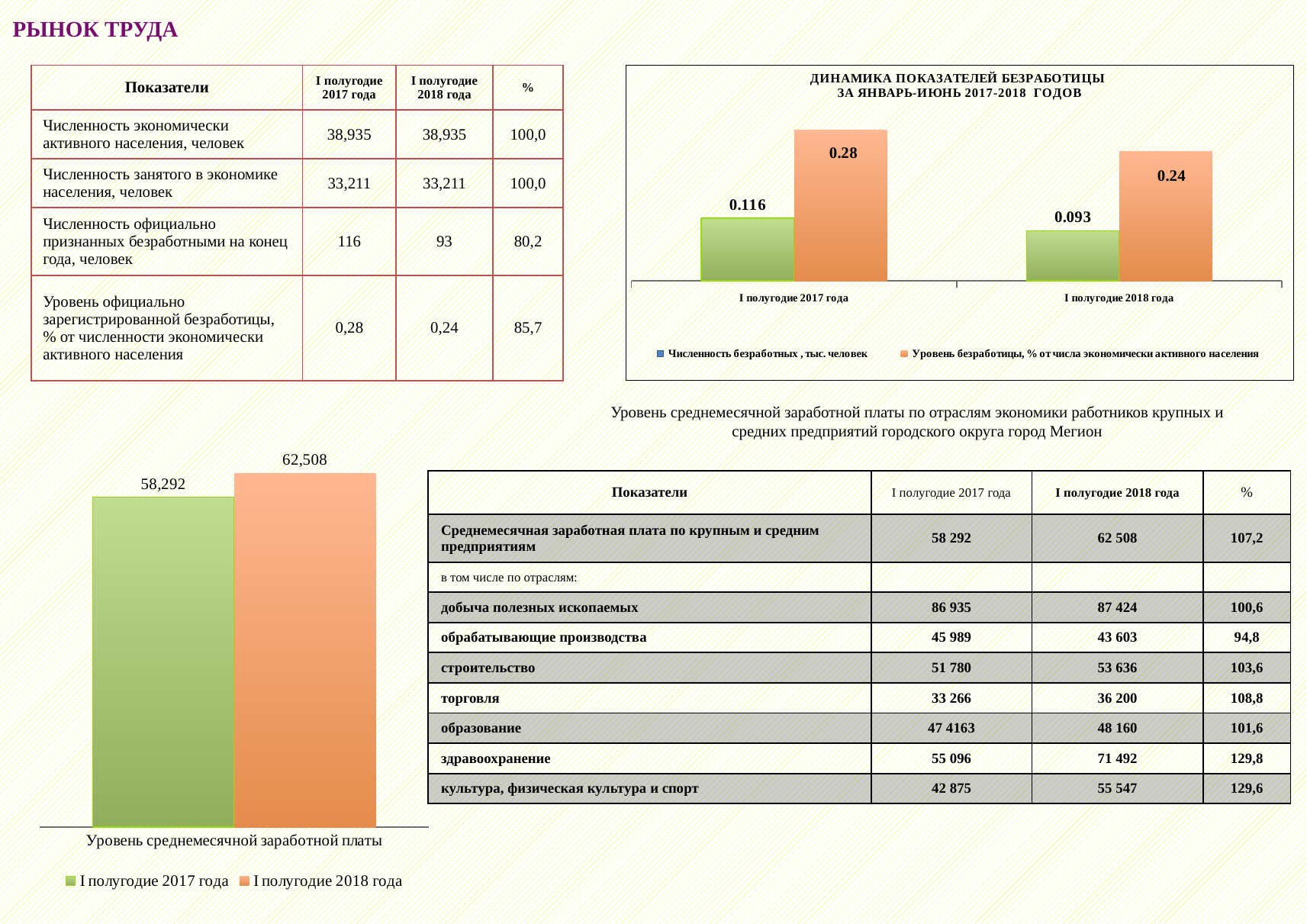
In the chart titled 'ДИНАМИКА ПОКАЗАТЕЛЕЙ БЕЗРАБОТИЦЫ ЗА ЯНВАРЬ-ИЮНЬ 2017-2018 ГОДОВ', what is the value of 'Численность безработных, тыс. человек' for 'I полугодие 2018 года'? 0.093 In the chart titled 'ДИНАМИКА ПОКАЗАТЕЛЕЙ БЕЗРАБОТИЦЫ ЗА ЯНВАРЬ-ИЮНЬ 2017-2018 ГОДОВ', does the 'Уровень безработицы' series rise or fall from 'I полугодие 2017 года' to 'I полугодие 2018 года'? fall In the chart at the bottom left titled 'Уровень среднемесячной заработной платы', how many series does the legend list? 2 In the chart titled 'ДИНАМИКА ПОКАЗАТЕЛЕЙ БЕЗРАБОТИЦЫ ЗА ЯНВАРЬ-ИЮНЬ 2017-2018 ГОДОВ', what is the value of 'Уровень безработицы, % от числа экономически активного населения' for 'I полугодие 2018 года'? 0.24 In the chart at the bottom left titled 'Уровень среднемесячной заработной платы', what is the value for 'I полугодие 2017 года'? 58,292 In the chart at the bottom left titled 'Уровень среднемесячной заработной платы', what is the difference between the values for 'I полугодие 2018 года' and 'I полугодие 2017 года'? 4,216 In the chart titled 'ДИНАМИКА ПОКАЗАТЕЛЕЙ БЕЗРАБОТИЦЫ ЗА ЯНВАРЬ-ИЮНЬ 2017-2018 ГОДОВ', how many series does the legend list? 2 In the chart at the bottom left titled 'Уровень среднемесячной заработной платы', what is the value for 'I полугодие 2018 года'? 62,508 In the chart titled 'ДИНАМИКА ПОКАЗАТЕЛЕЙ БЕЗРАБОТИЦЫ ЗА ЯНВАРЬ-ИЮНЬ 2017-2018 ГОДОВ', what kind of chart is shown? bar chart In the chart titled 'ДИНАМИКА ПОКАЗАТЕЛЕЙ БЕЗРАБОТИЦЫ ЗА ЯНВАРЬ-ИЮНЬ 2017-2018 ГОДОВ', which period has the higher value for 'Численность безработных, тыс. человек'? I полугодие 2017 года In the chart at the bottom left titled 'Уровень среднемесячной заработной платы', which period has the larger value? I полугодие 2018 года In the chart titled 'ДИНАМИКА ПОКАЗАТЕЛЕЙ БЕЗРАБОТИЦЫ ЗА ЯНВАРЬ-ИЮНЬ 2017-2018 ГОДОВ', what is the value of 'Численность безработных, тыс. человек' for 'I полугодие 2017 года'? 0.116